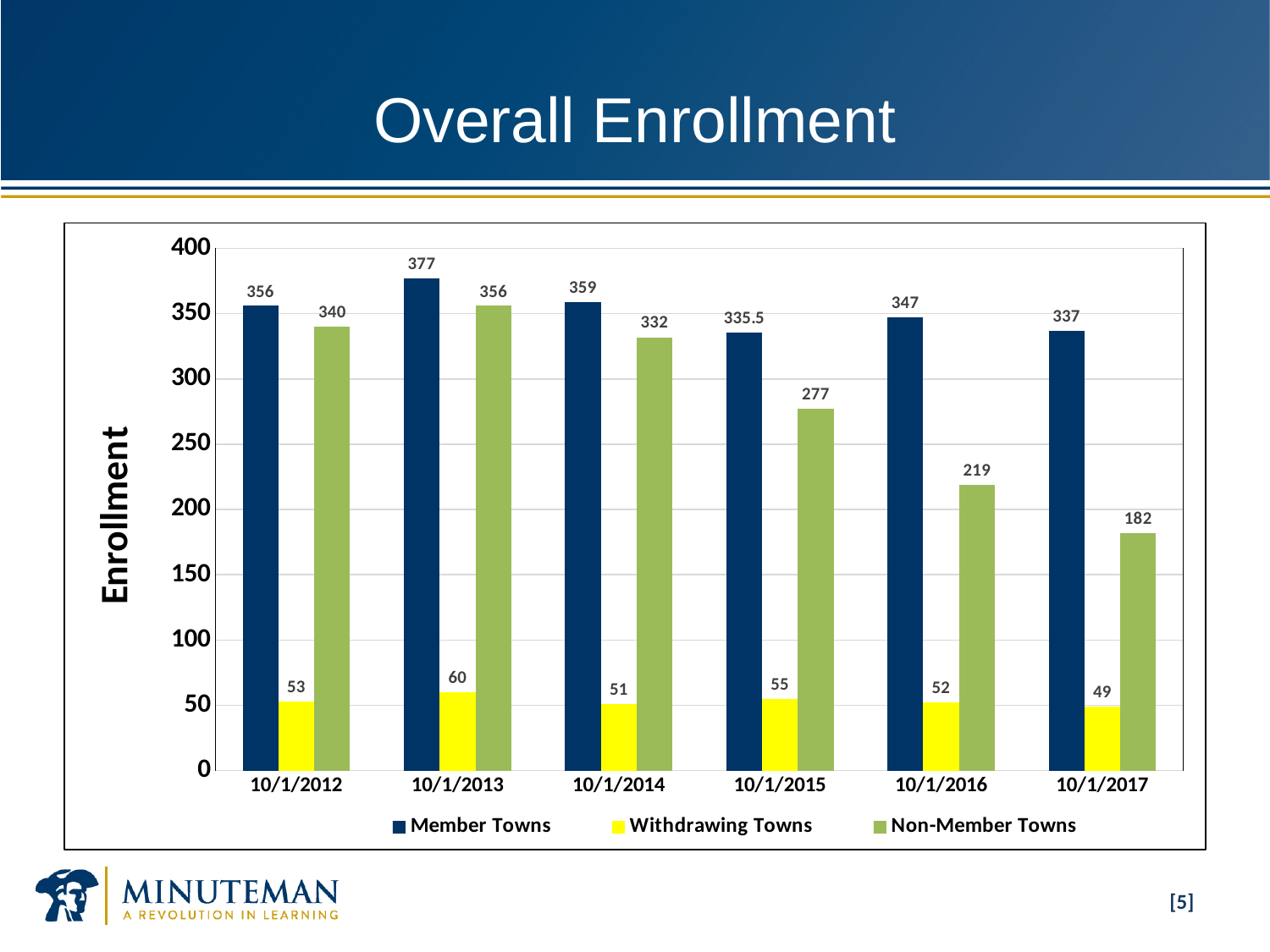
What is the Non-Member Towns enrollment on 10/1/2017? 182 How many series does the legend list? 3 What is the Member Towns enrollment on 10/1/2015? 335.5 On which date is the Non-Member Towns enrollment lowest? 10/1/2017 How many dates are shown on the x axis? 6 What is the difference between the Non-Member Towns enrollment on 10/1/2012 and on 10/1/2017? 158 Which is larger on 10/1/2014: Member Towns or Non-Member Towns enrollment? Member Towns What is the Withdrawing Towns enrollment on 10/1/2015? 55 What kind of chart is shown? Bar chart On which date is the Member Towns enrollment highest? 10/1/2013 What is the Member Towns enrollment on 10/1/2013? 377 Does the Non-Member Towns enrollment rise or fall from 10/1/2013 to 10/1/2017? Fall